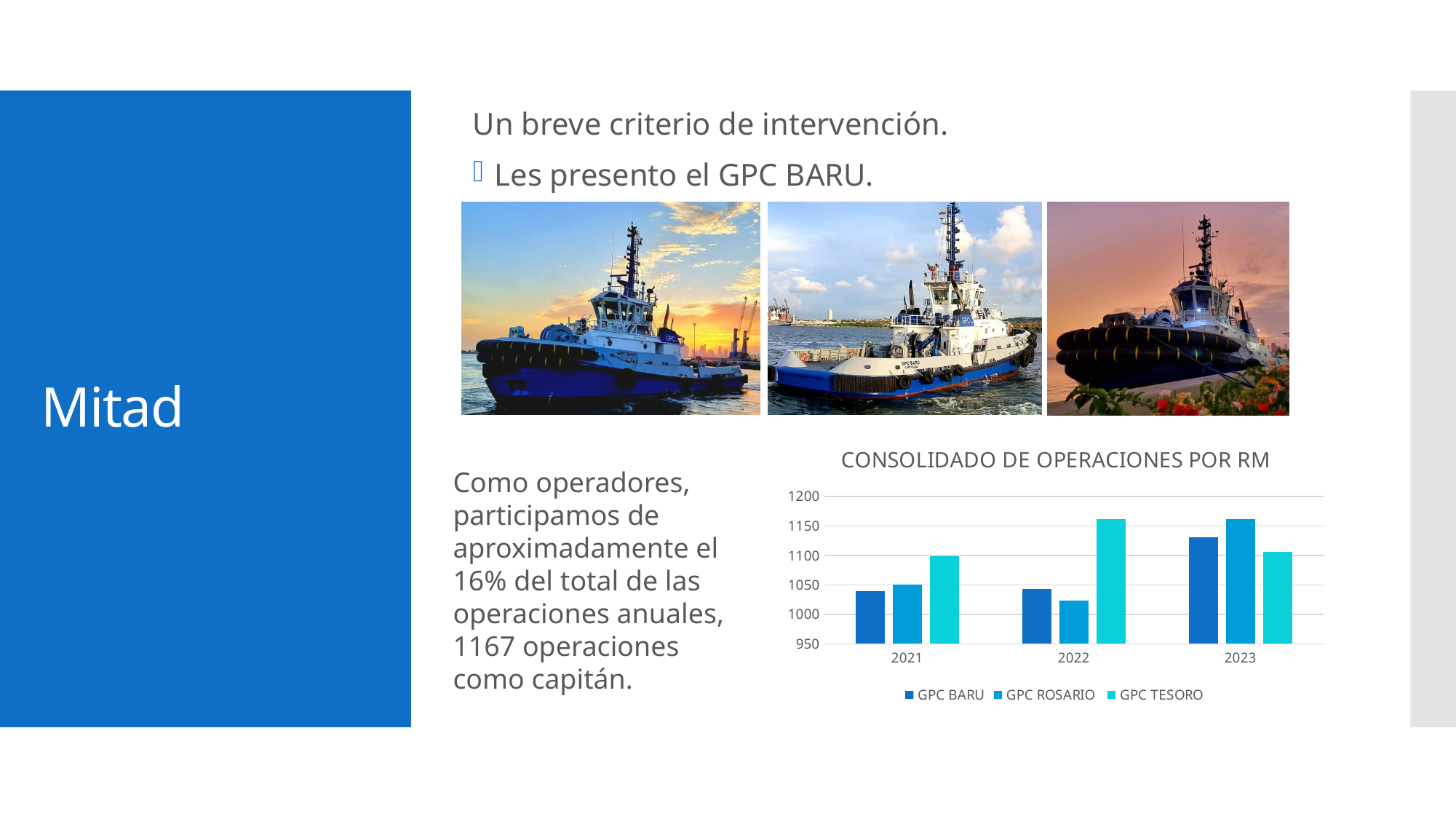
Which is larger in 2022, GPC BARU or GPC TESORO? GPC TESORO Is the value for GPC ROSARIO in 2022 greater or less than 1050? less How many years are shown on the x axis of the chart? 3 Is the value for GPC TESORO in 2022 greater or less than 1150? greater What type of chart is shown on the slide? bar chart Which series has the highest value in 2023? GPC ROSARIO What is the title of the chart on the slide? CONSOLIDADO DE OPERACIONES POR RM How many series does the chart legend list? 3 Which series has the lowest value in 2022? GPC ROSARIO Which series has the highest value in 2021? GPC TESORO Which series has the highest value in 2022? GPC TESORO Is the value for GPC BARU in 2023 greater or less than 1100? greater